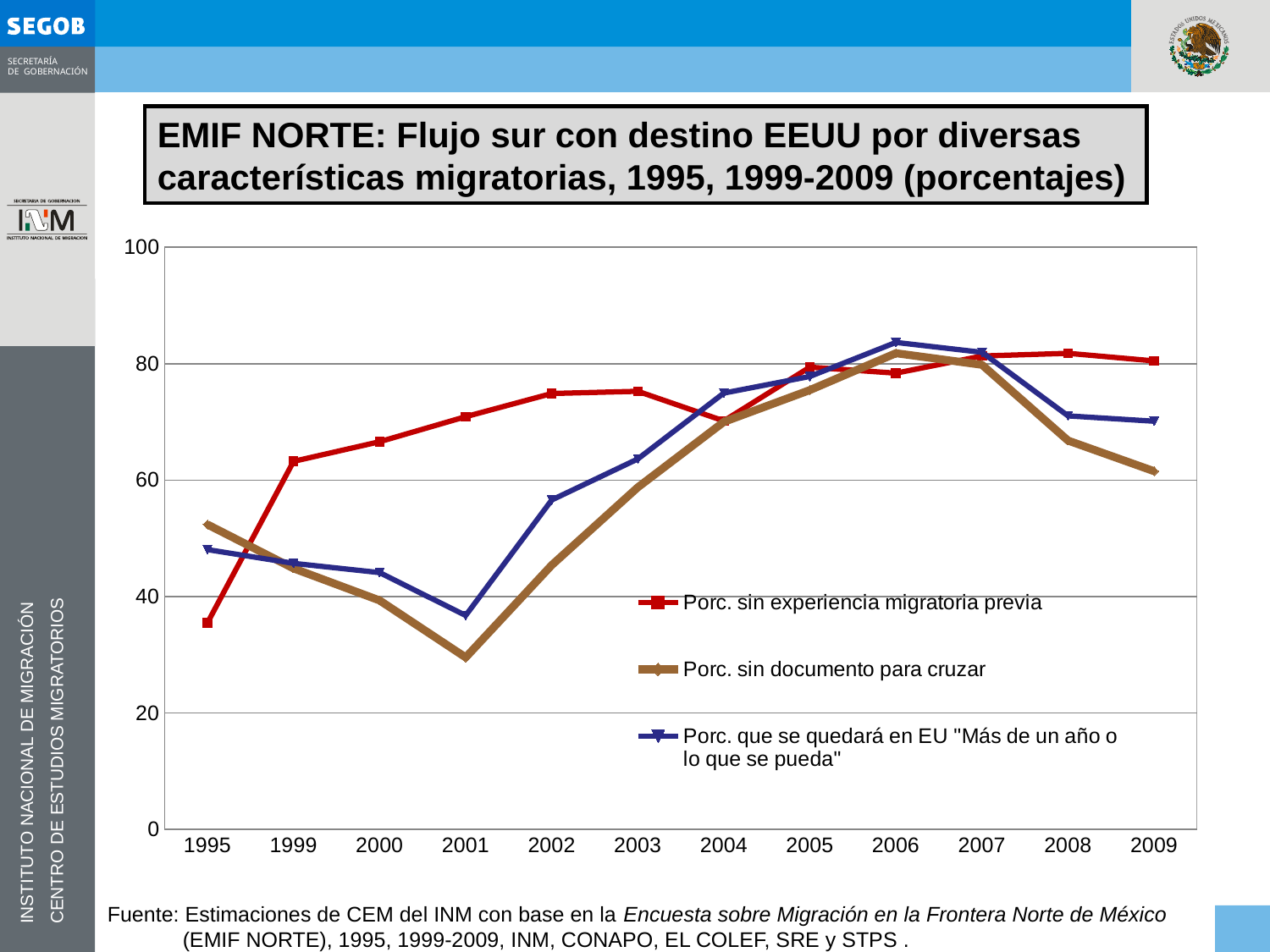
In 2009, which is higher: "Porc. sin experiencia migratoria previa" or "Porc. sin documento para cruzar"? Porc. sin experiencia migratoria previa Is the value for "Porc. que se quedará en EU 'Más de un año o lo que se pueda'" in 2006 greater or less than 80? greater Does "Porc. sin documento para cruzar" rise or fall from 2006 to 2009? fall How many series does the legend list? 3 Is the value for "Porc. sin experiencia migratoria previa" in 2003 greater or less than 60? greater In which year is "Porc. que se quedará en EU 'Más de un año o lo que se pueda'" at its lowest? 2001 In which year is "Porc. sin documento para cruzar" at its lowest? 2001 Is the value for "Porc. sin experiencia migratoria previa" in 1995 greater or less than 40? less In 1995, which is higher: "Porc. sin experiencia migratoria previa" or "Porc. sin documento para cruzar"? Porc. sin documento para cruzar What kind of chart is shown on the slide? line chart How many years are shown along the x axis? 12